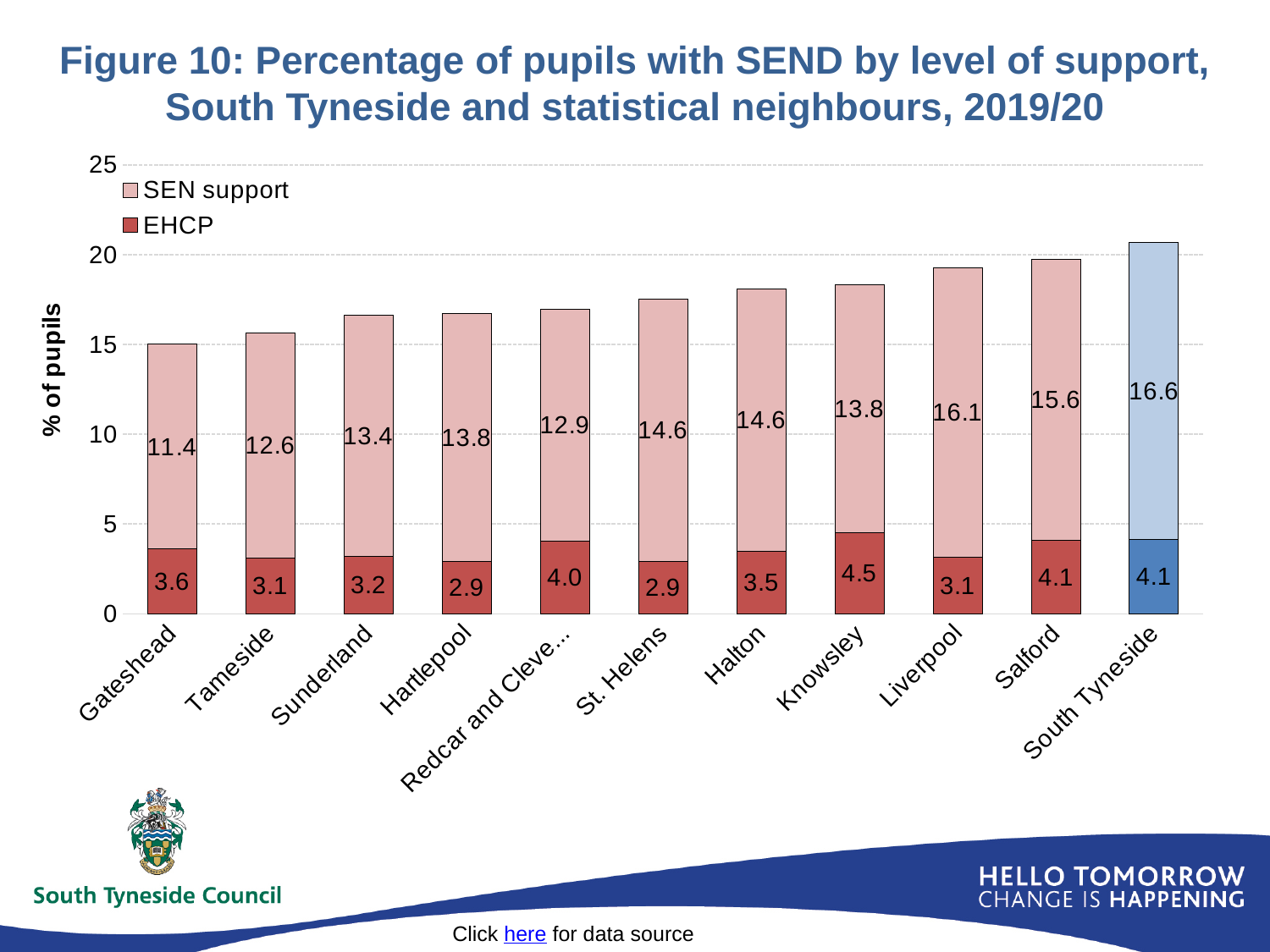
What is the SEN support value for Liverpool? 16.1 Which has the larger EHCP value, Gateshead or Halton? Gateshead What is the total percentage of pupils with SEND for South Tyneside (SEN support plus EHCP)? 20.7 Which area has the highest EHCP value? Knowsley What is the EHCP value for Knowsley? 4.5 Which area has the lowest SEN support value? Gateshead How many areas are shown on the x axis? 11 What is the difference between the SEN support values for South Tyneside and Gateshead? 5.2 What kind of chart is shown on the slide? Stacked bar chart Is the total bar height for South Tyneside greater or less than 20? greater Do the total bar heights rise or fall from left to right across the x axis? Rise How many series does the legend list? 2